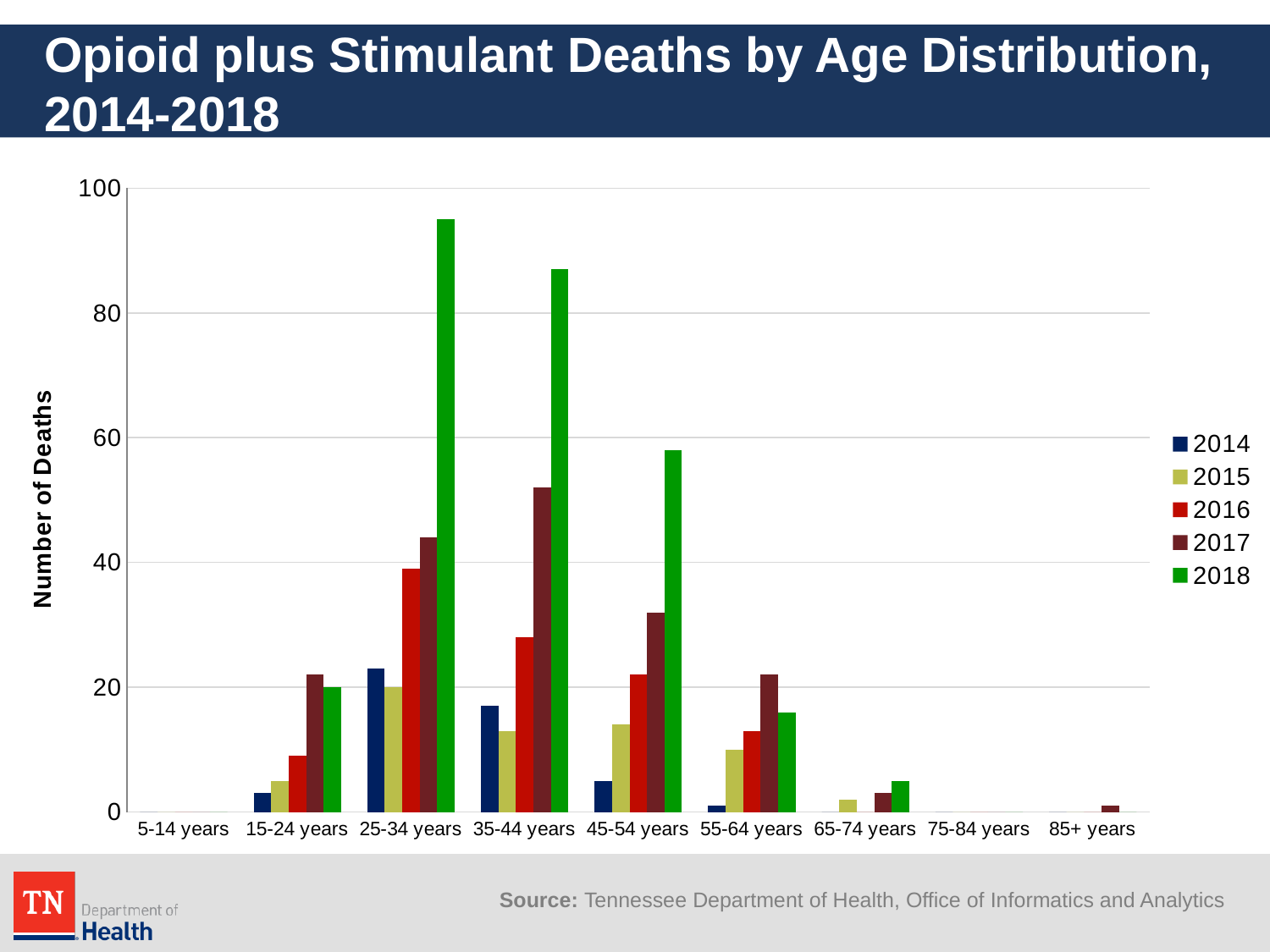
Is the 2017 value for 35-44 years greater or less than 40? greater Which year has the lowest bar for the 55-64 years group? 2014 How many series does the legend list? 5 Which age group has the highest 2018 bar? 25-34 years Is the 2018 value for 35-44 years greater or less than 80? greater For the 45-54 years group, do the values rise or fall from 2014 to 2018? Rise Is the 2018 value for 25-34 years greater or less than 80? greater Which is larger: the 2016 value for 25-34 years or the 2016 value for 35-44 years? 25-34 years How many age groups are shown on the x axis? 9 For the 45-54 years group, which is larger: the 2017 value or the 2018 value? 2018 What kind of chart is shown on the slide? Bar chart